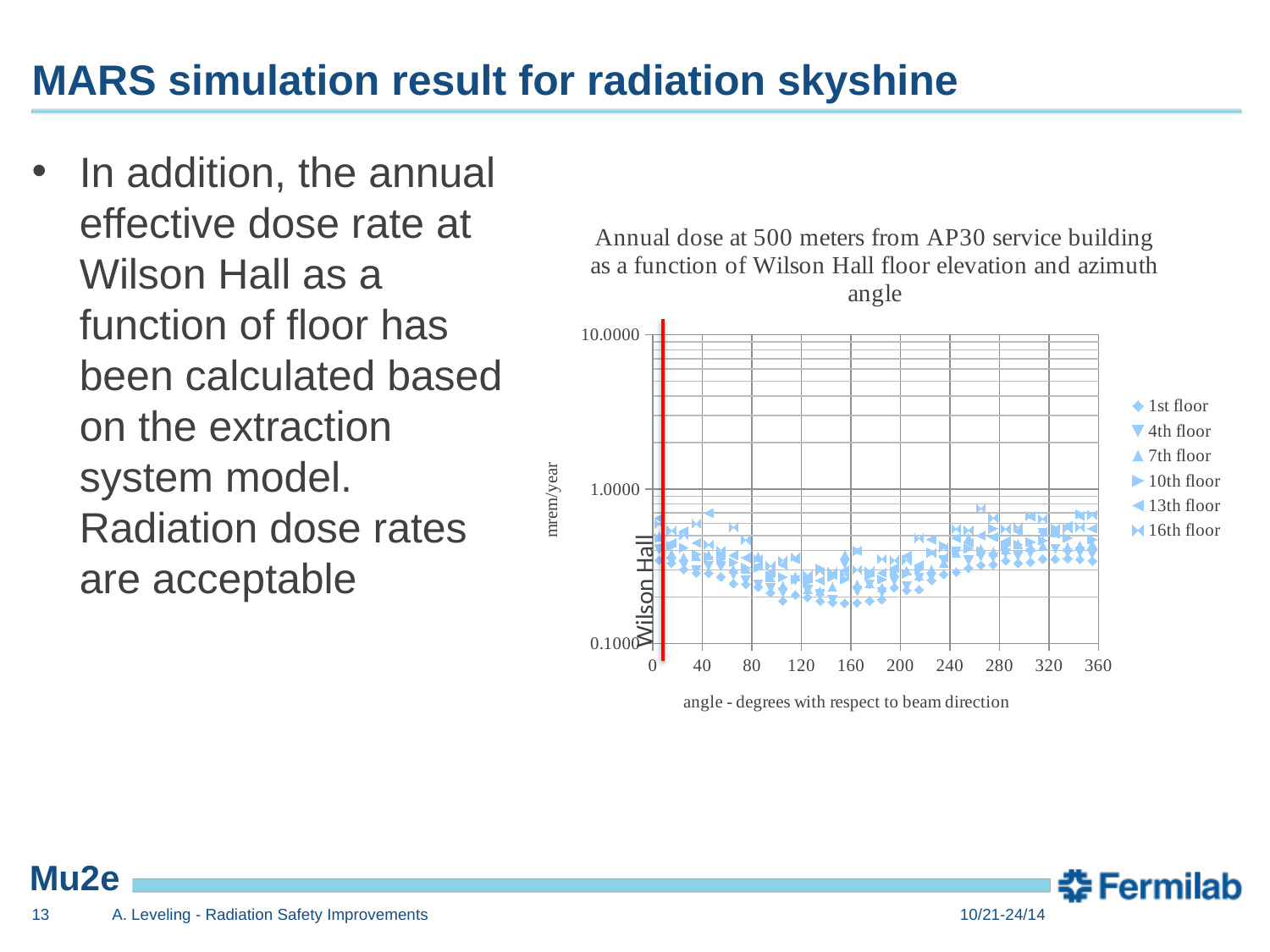
What is the lowest value shown on the vertical axis of the chart? 0.1000 What is the largest angle shown on the horizontal axis of the chart? 360 Which floor is listed first in the chart legend? 1st floor Are the plotted dose values at an angle of 160 degrees greater or less than 1.0000 mrem/year? less How many series does the legend of the chart list? 6 What kind of chart is shown on the slide? scatter chart Are the plotted dose values at an angle of 160 degrees greater or less than 0.1000 mrem/year? greater